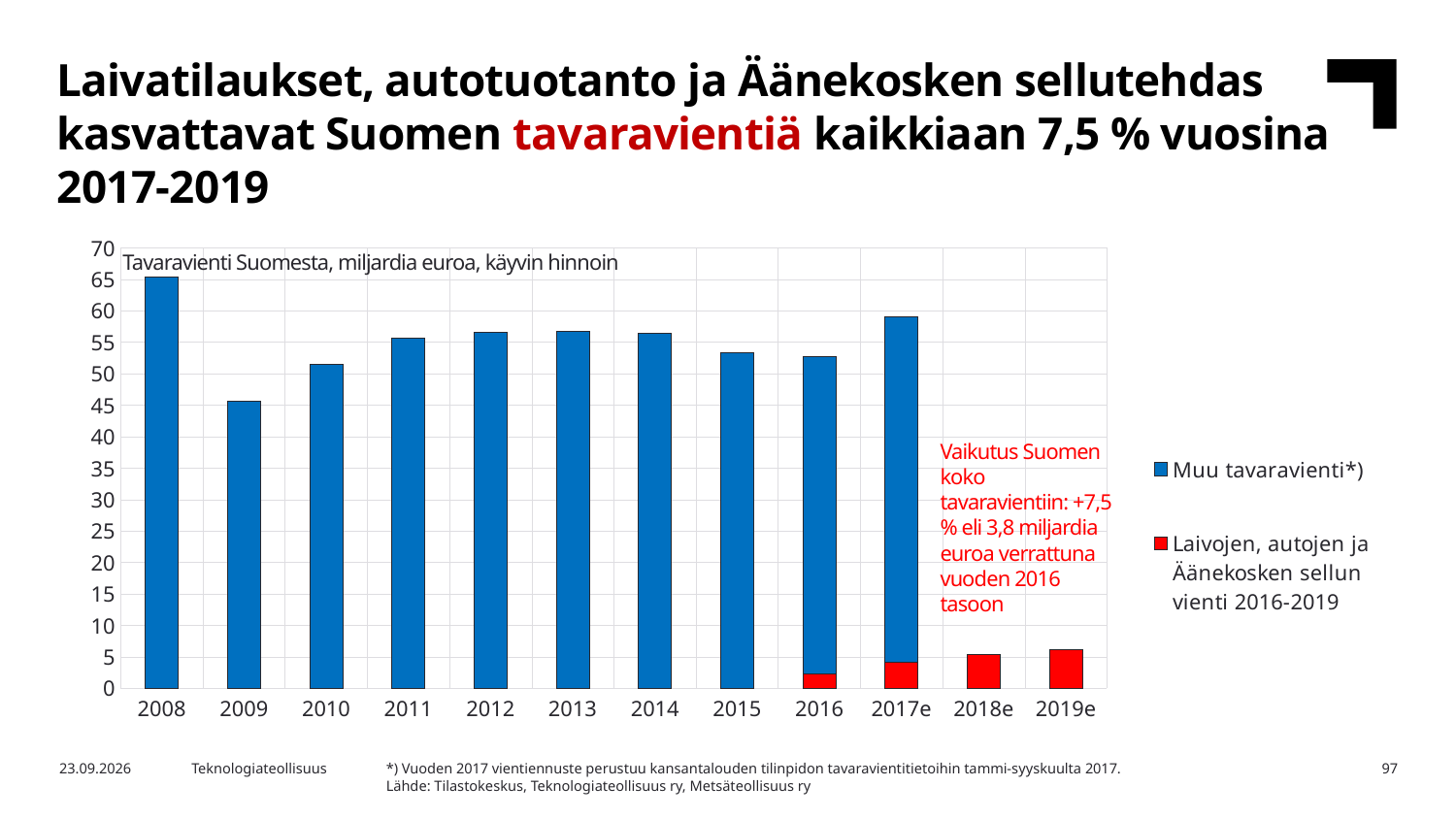
Which is larger, the total bar for 2016 or for 2017e? 2017e How many years are shown on the x axis? 12 Which year has the highest value for Muu tavaravienti*)? 2008 Do the values rise or fall from 2009 to 2013? rise Is the total bar for 2017e greater or less than 55? greater Which year has the lowest value for Muu tavaravienti*)? 2009 How many series does the legend list? 2 What is the title printed inside the chart area? Tavaravienti Suomesta, miljardia euroa, käyvin hinnoin Is the value for 2009 greater or less than 50? less Is the value for 2018e greater or less than 10? less What kind of chart is shown on the slide? bar chart